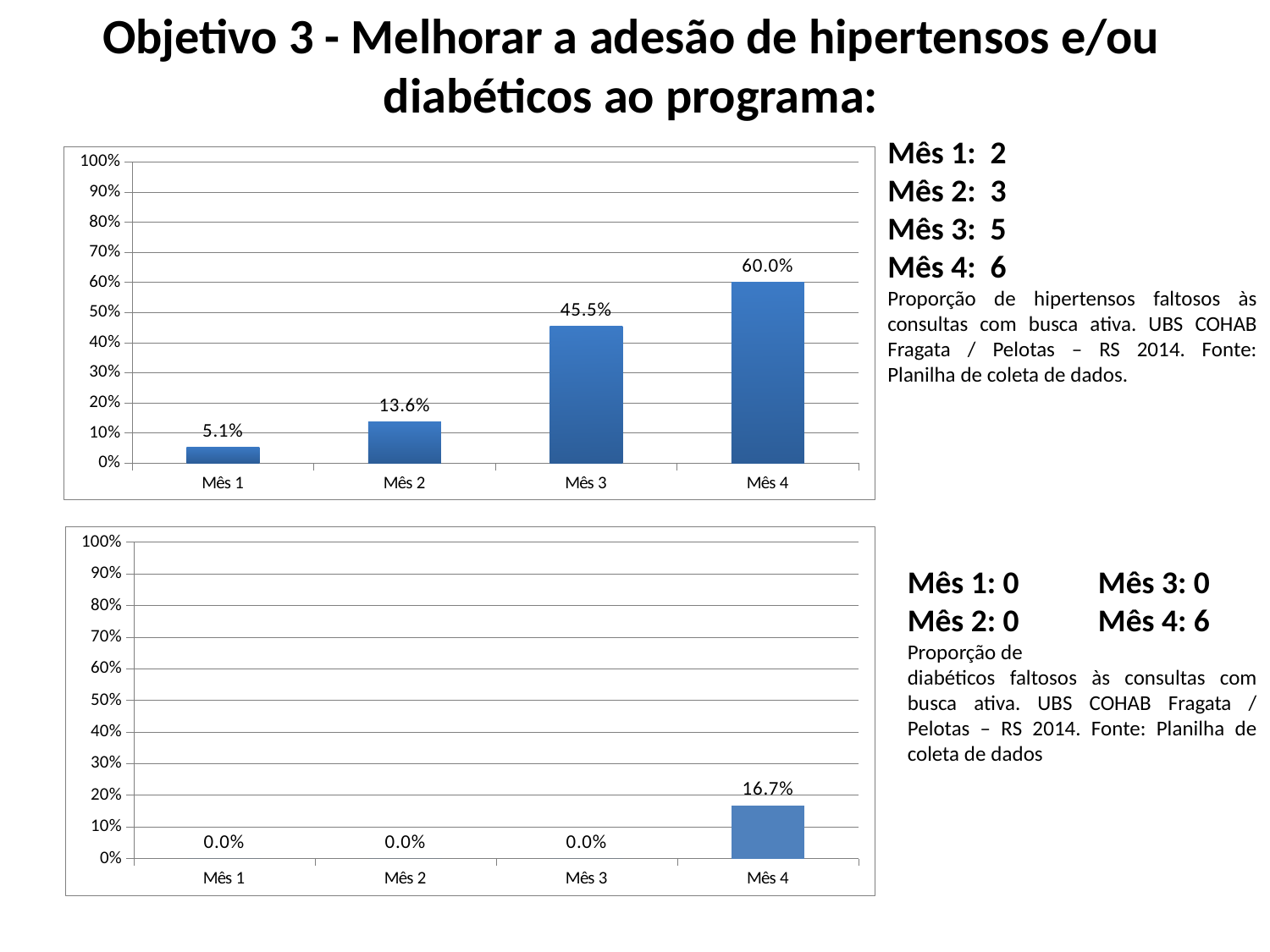
In the top chart, which month has the highest value? Mês 4 In the bottom chart, which is larger, the value for Mês 4 or the value for Mês 3? Mês 4 In the top chart, what is the value for Mês 1? 5.1% In the top chart, do the values rise or fall from Mês 1 to Mês 4? rise What kind of chart is the top chart? bar chart In the bottom chart, what is the value for Mês 2? 0.0% In the top chart, what is the value for Mês 3? 45.5% In the top chart, which month has the lowest value? Mês 1 In the bottom chart, how many months are shown on the x axis? 4 In the bottom chart, what is the value for Mês 4? 16.7% In the top chart, what is the difference between the values for Mês 4 and Mês 3? 14.5% In the top chart, is the value for Mês 2 greater or less than 20%? less